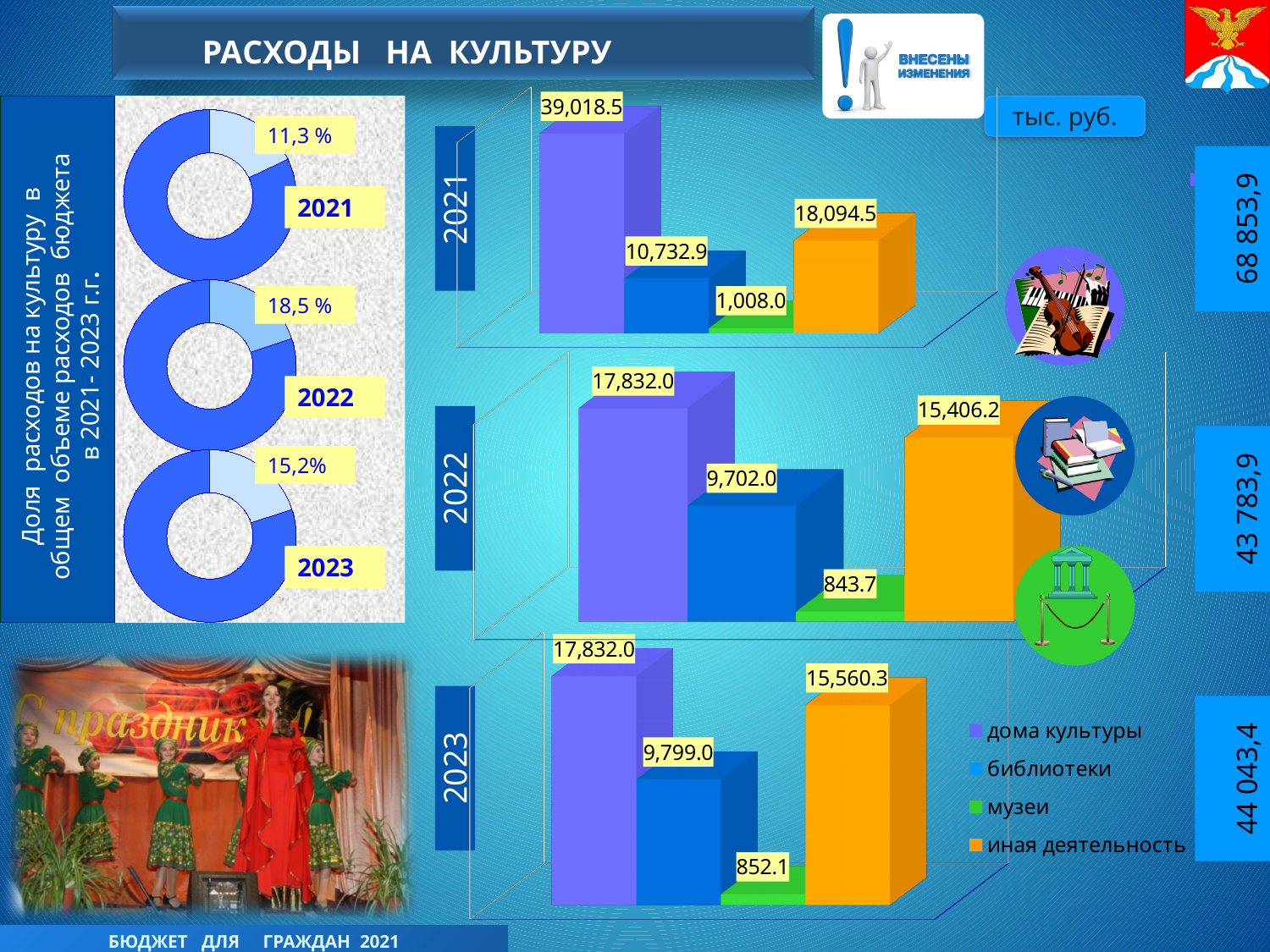
In the 2022 bar chart, which is larger: библиотеки or иная деятельность? иная деятельность In the 2021 bar chart, what is the value for дома культуры? 39,018.5 What kind of chart is used to show the 2021, 2022 and 2023 expenditure breakdowns? bar chart In the 2021 bar chart, which category has the highest value? дома культуры In the 2023 bar chart, what is the value for библиотеки? 9,799.0 In the 2022 bar chart, which category has the lowest value? музеи In the donut chart for 2022, what share of total budget expenses goes to culture? 18,5 % In the 2022 bar chart, what is the value for иная деятельность? 15,406.2 In the donut chart for 2023, what share of total budget expenses goes to culture? 15,2% How many series does the legend of the bar charts list? 4 In the 2023 bar chart, what is the difference between дома культуры and иная деятельность? 2,271.7 In the 2021 bar chart, what is the value for музеи? 1,008.0